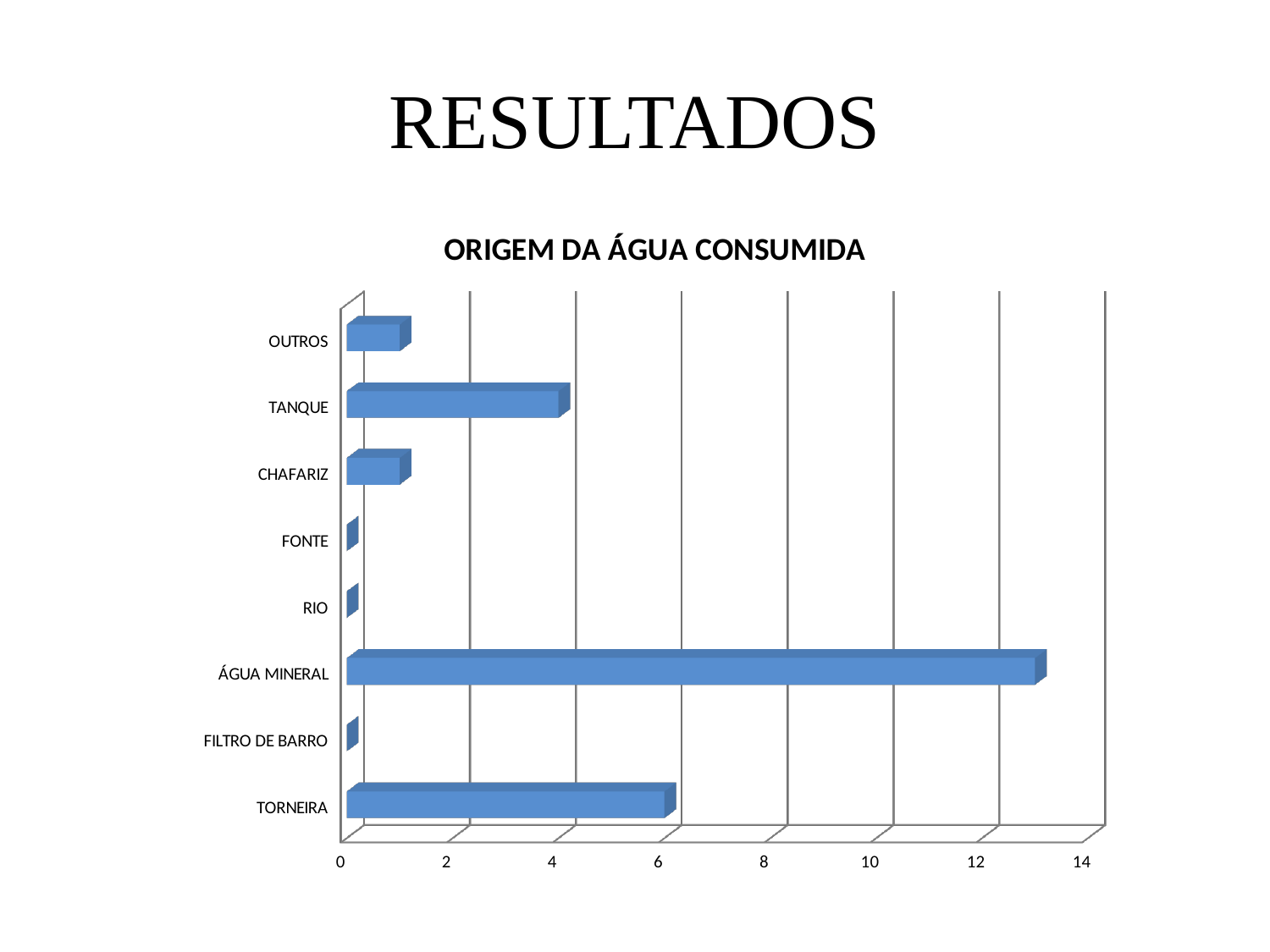
Which category has the highest value? ÁGUA MINERAL Is the value for TORNEIRA greater or less than 4? greater What type of chart is shown on the slide? bar chart Is the value for OUTROS greater or less than 2? less Is the value for CHAFARIZ greater or less than 2? less Which is larger, the value for TORNEIRA or the value for TANQUE? TORNEIRA What colour are the bars in the chart? blue Which is larger, the value for ÁGUA MINERAL or the value for TORNEIRA? ÁGUA MINERAL What is the title of the chart? ORIGEM DA ÁGUA CONSUMIDA How many categories are shown on the chart? 8